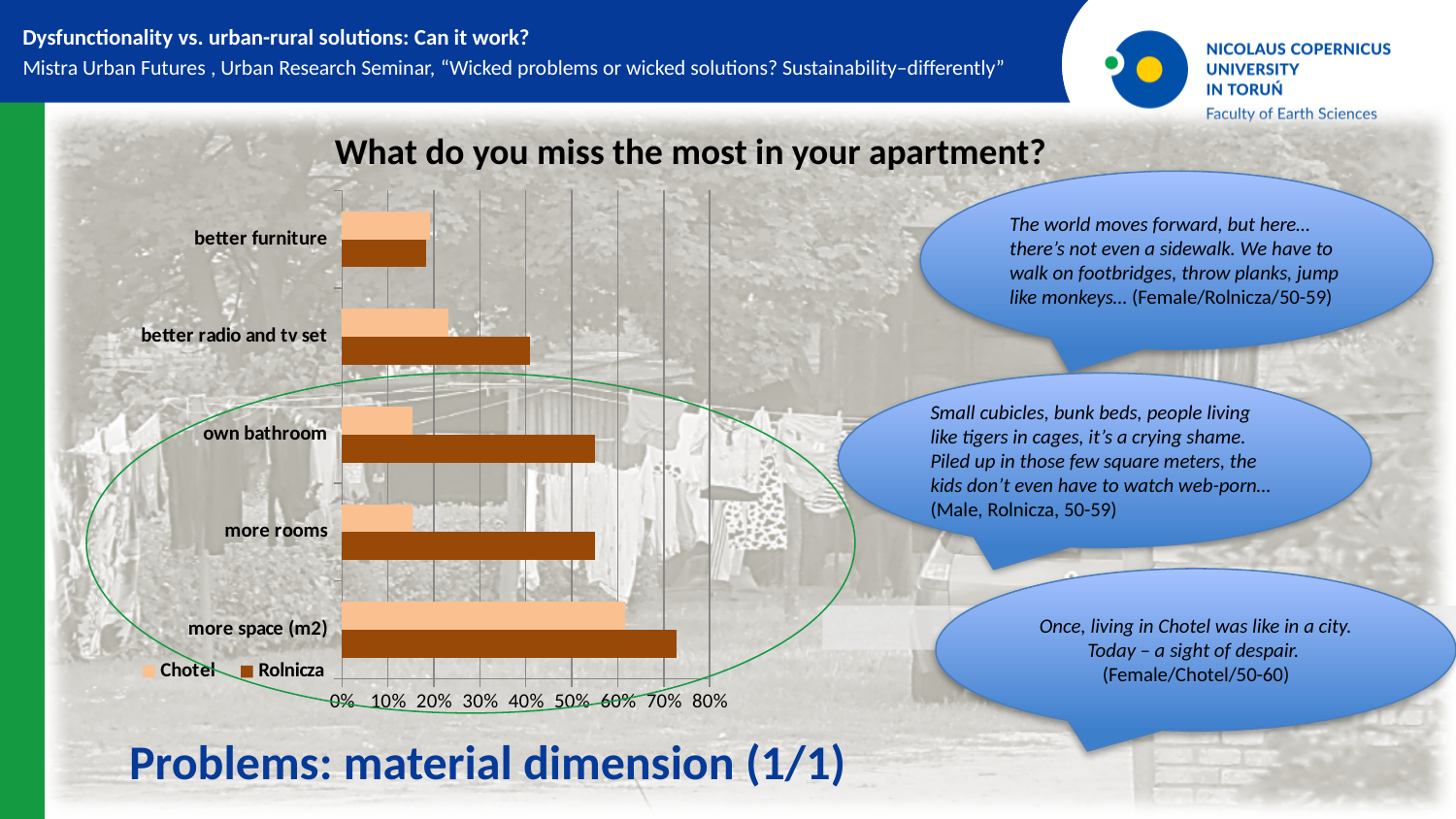
Which category has the highest value for the Chotel series? more space (m2) For 'better radio and tv set', which series has the larger value, Chotel or Rolnicza? Rolnicza For 'more rooms', which series has the larger value, Chotel or Rolnicza? Rolnicza Is the Chotel value for 'own bathroom' greater or less than 20%? less Which category has the highest value for the Rolnicza series? more space (m2) Is the Rolnicza value for 'own bathroom' greater or less than 50%? greater How many categories does the chart show? 5 Is the Rolnicza value for 'more space (m2)' greater or less than 60%? greater What is the title of the chart? What do you miss the most in your apartment? What kind of chart is shown on the slide? bar chart How many series does the legend list? 2